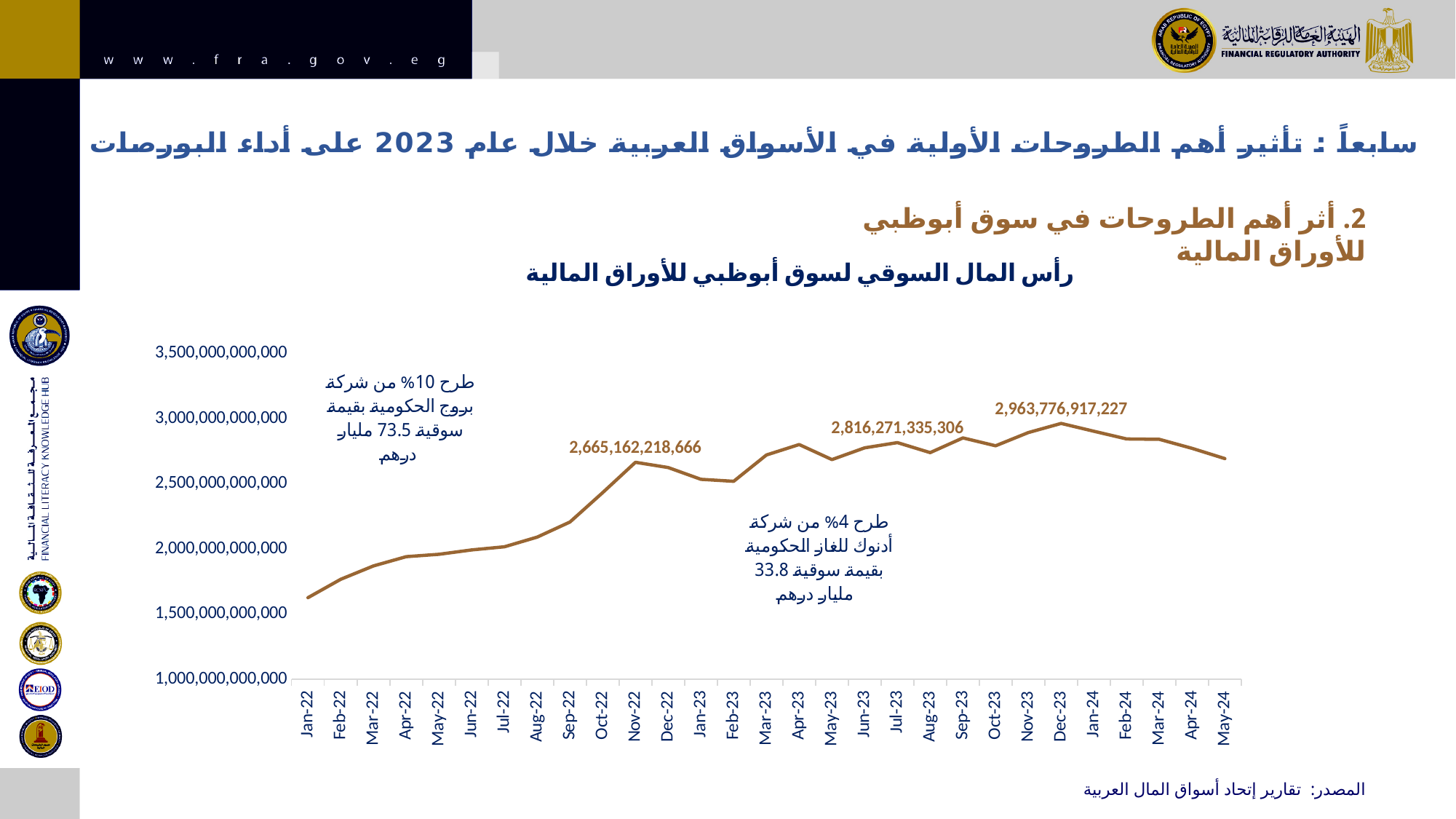
Is the value for Jan-22 greater or less than 2,000,000,000,000? less What kind of chart is shown on the slide? line chart Is the value for May-24 greater or less than 2,500,000,000,000? greater What is the title of the chart? رأس المال السوقي لسوق أبوظبي للأوراق المالية Which month has the lowest market capitalization on the chart? Jan-22 Does the market capitalization generally rise or fall from Jan-22 to Dec-23? rise What is the market capitalization value labelled at Dec-23? 2,963,776,917,227 How many monthly points are plotted on the x axis? 29 What is the market capitalization value labelled at Nov-22? 2,665,162,218,666 Which month has the highest market capitalization on the chart? Dec-23 Which is larger, the value for Dec-23 or the value for Nov-22? Dec-23 What is the difference between the labelled values at Dec-23 and Nov-22? 298,614,698,561